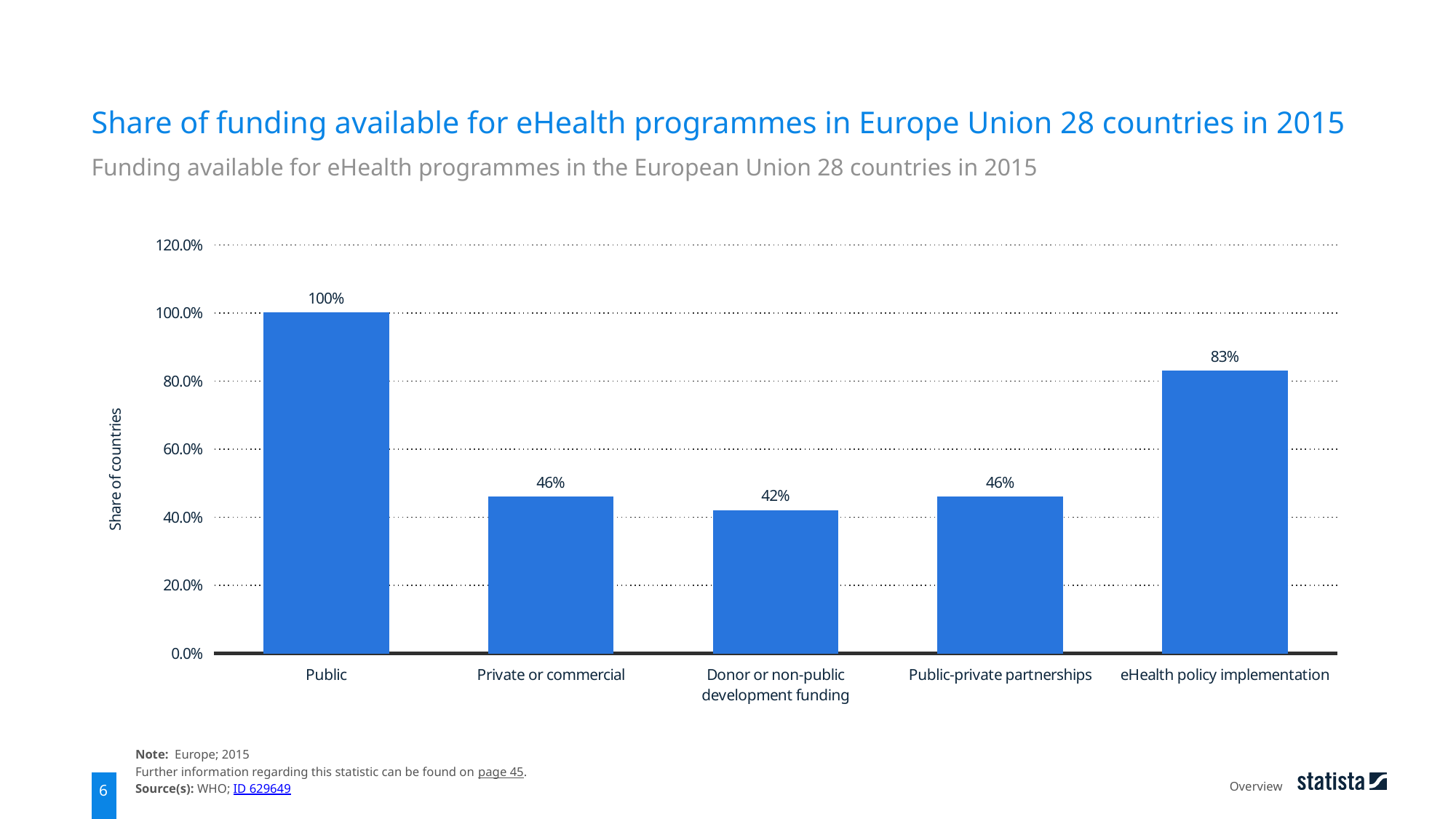
What is the share of countries for eHealth policy implementation? 83% What is the share of countries for Donor or non-public development funding? 42% What is the label of the vertical axis? Share of countries What is the share of countries for Public funding? 100% Which funding category has the highest share of countries? Public What kind of chart is shown on the slide? Bar chart Which funding category has the lowest share of countries? Donor or non-public development funding What is the share of countries for Public-private partnerships? 46% Which is larger, the share for eHealth policy implementation or the share for Public-private partnerships? eHealth policy implementation How many funding categories are shown in the chart? 5 What is the difference between the share for Private or commercial and the share for Donor or non-public development funding? 4% What is the difference between the share for Public and the share for eHealth policy implementation? 17%